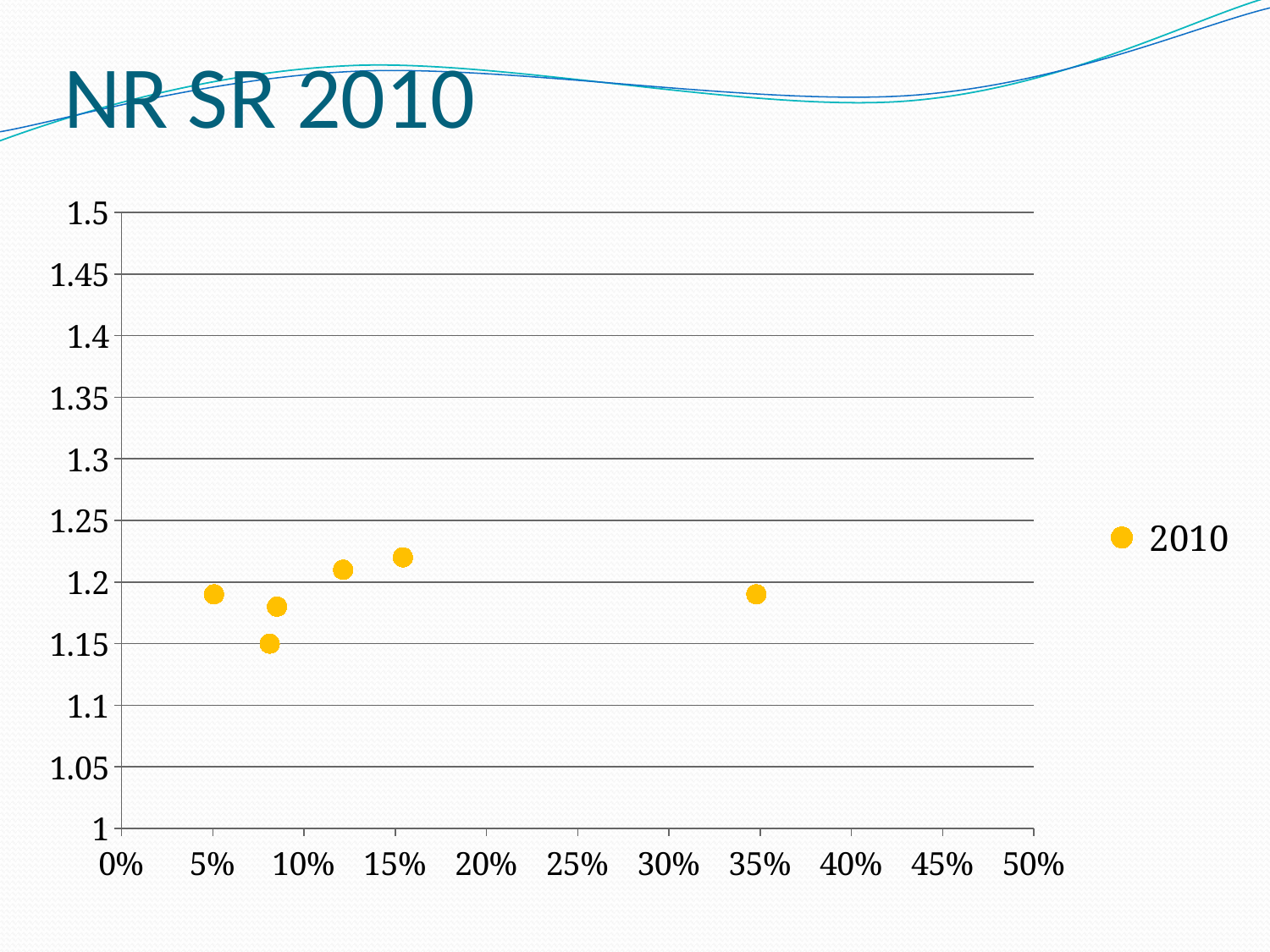
Are all the plotted points below 1.25 on the y axis? yes Is the value of the point plotted at about 5% on the x axis greater or less than 1.15? greater What is the name of the series shown in the legend? 2010 How many data points are plotted on the chart? 6 What is the maximum value shown on the y axis? 1.5 Which of the two points plotted near 8% on the x axis is lower, the one at about 1.15 or the one at about 1.18? the one at about 1.15 What is the title of the slide containing the chart? NR SR 2010 Is the value of the point plotted at about 35% on the x axis greater or less than 1.25? less What kind of chart is shown on the slide? scatter chart How many series does the legend list? 1